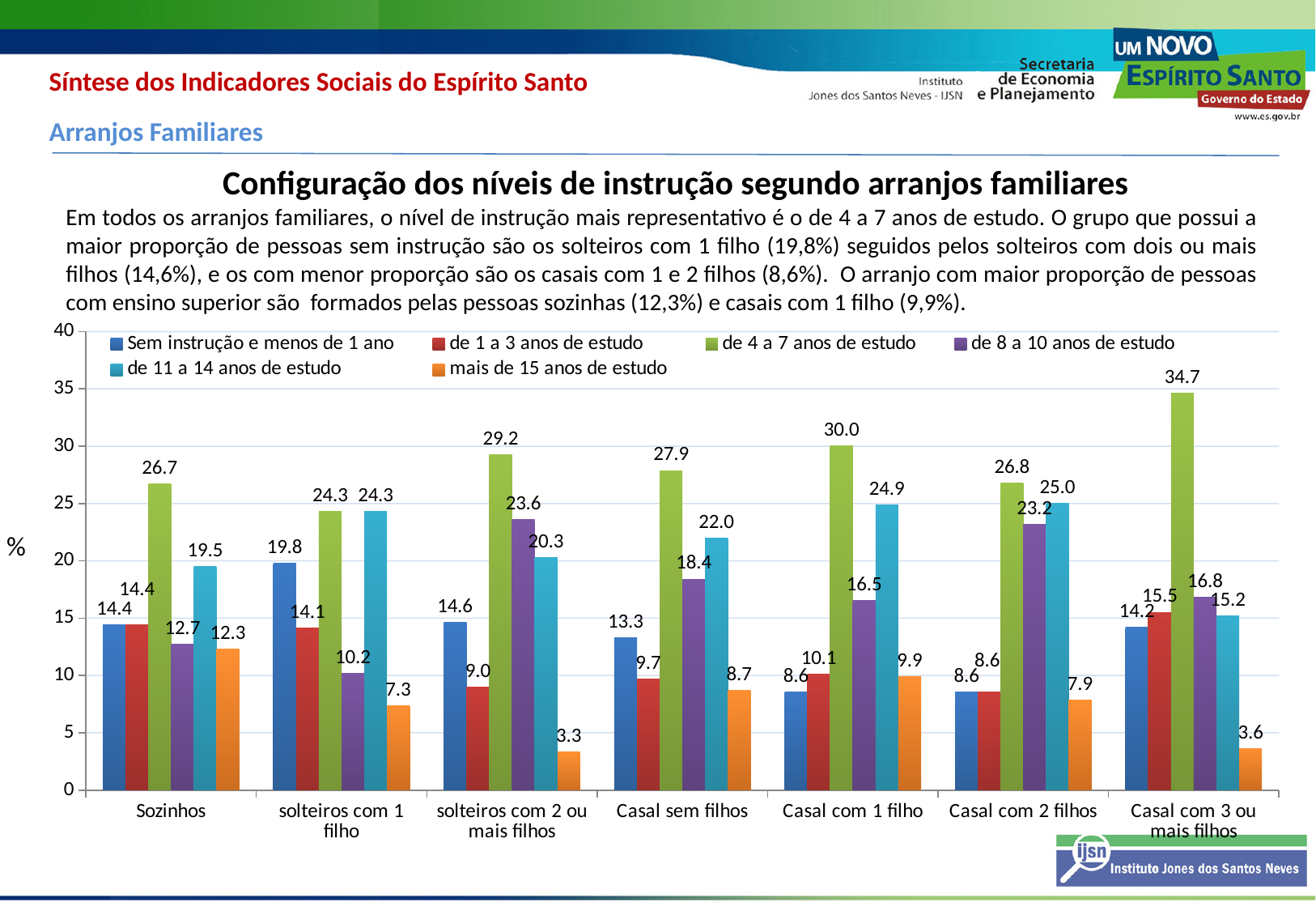
What is the difference between the 'de 4 a 7 anos de estudo' values for 'Casal com 3 ou mais filhos' and 'Casal com 1 filho'? 4.7 What is the value for 'Sem instrução e menos de 1 ano' in the 'solteiros com 1 filho' category? 19.8 What kind of chart is shown on the slide? Bar chart Which category has the lowest value for 'mais de 15 anos de estudo'? solteiros com 2 ou mais filhos Which category has the highest value for 'Sem instrução e menos de 1 ano'? solteiros com 1 filho How many series does the legend list? 6 What is the value for 'mais de 15 anos de estudo' in the 'Sozinhos' category? 12.3 Which is larger for 'de 8 a 10 anos de estudo': 'Sozinhos' or 'solteiros com 2 ou mais filhos'? solteiros com 2 ou mais filhos How many family arrangement categories are shown on the x axis? 7 Which category has the highest value for 'de 4 a 7 anos de estudo'? Casal com 3 ou mais filhos What is the title of the chart? Configuração dos níveis de instrução segundo arranjos familiares What is the value for 'de 4 a 7 anos de estudo' in the 'Casal com 3 ou mais filhos' category? 34.7